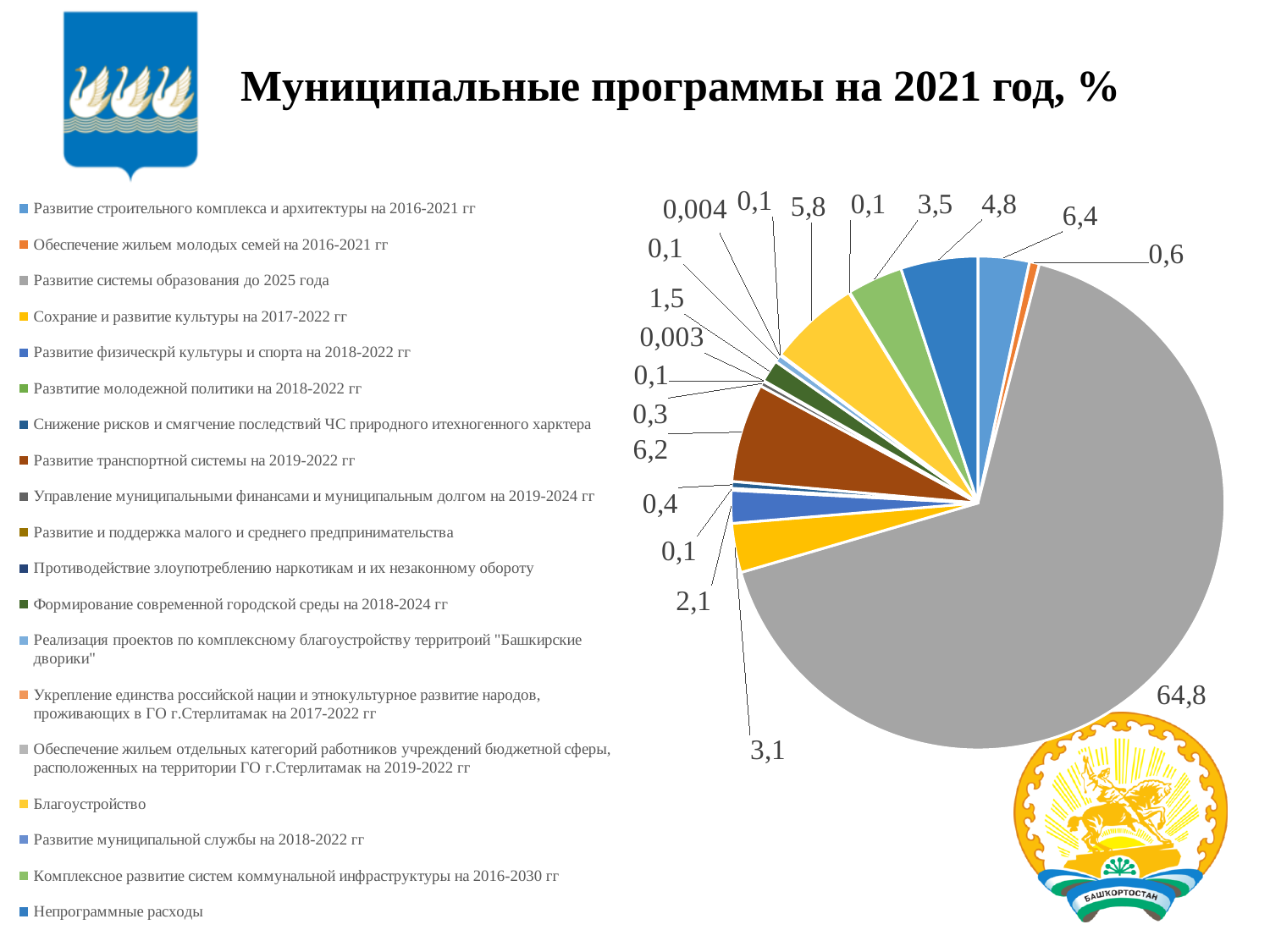
What is the smallest value labelled on the pie? 0,003 Which is larger: the value for Благоустройство or the value for Непрограммные расходы? Благоустройство What is the value for Непрограммные расходы? 4,8 What is the difference between the largest slice (64,8) and the slice for Развитие строительного комплекса и архитектуры (6,4)? 58,4 What is the value of the largest slice? 64,8 What kind of chart is shown on the slide? pie chart What is the title of the chart? Муниципальные программы на 2021 год, % What is the value for Развитие строительного комплекса и архитектуры на 2016-2021 гг? 6,4 What is the value for Развитие транспортной системы на 2019-2022 гг? 6,2 How many categories does the legend list? 19 Which category has the largest share of the pie? Развитие системы образования до 2025 года What is the value for Благоустройство? 5,8